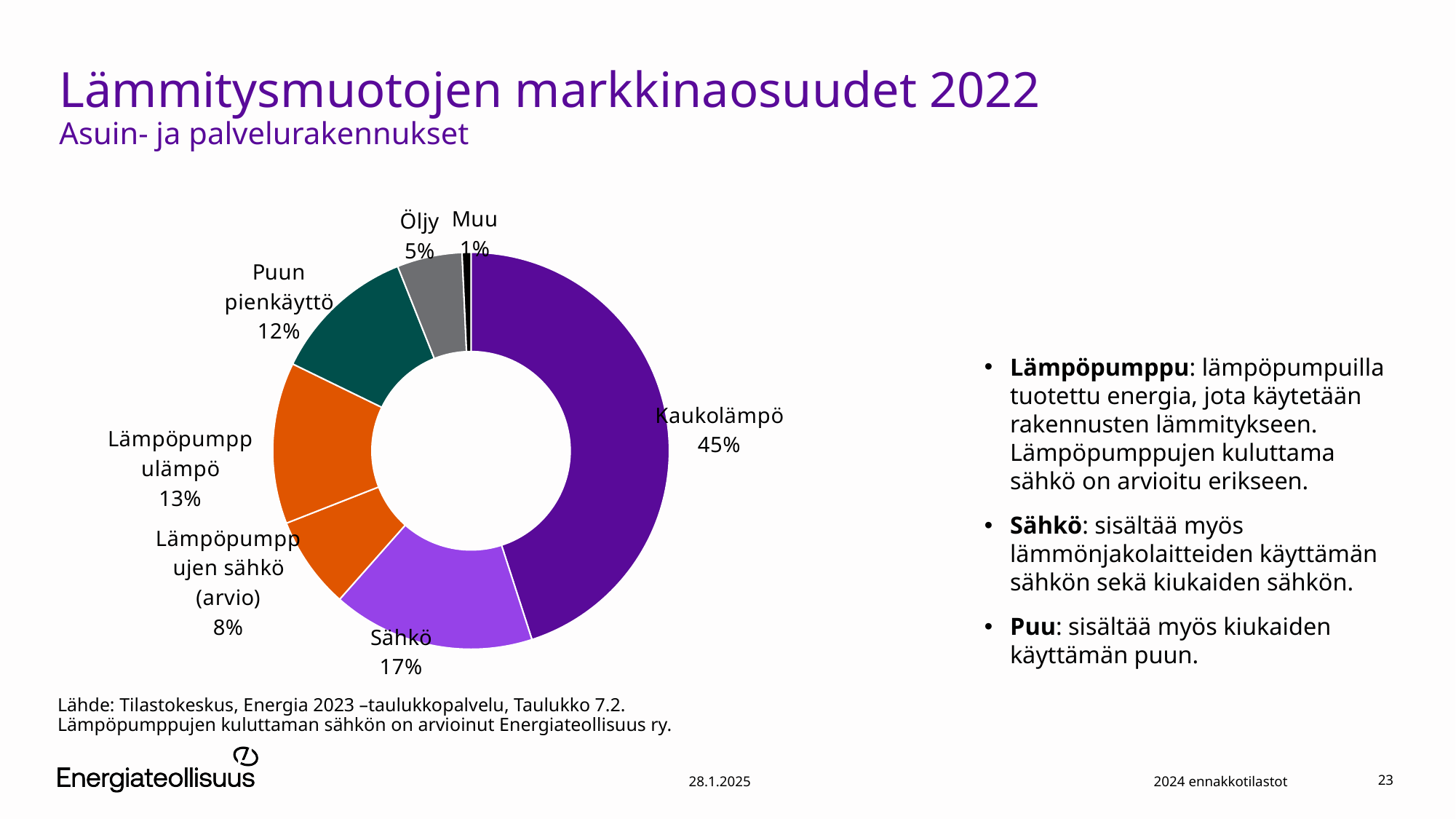
What kind of chart is shown on the slide? Pie chart (donut) Which category has the smallest share in the chart? Muu What share does Öljy have in the chart? 5% What share does Lämpöpumppujen sähkö (arvio) have in the chart? 8% Which has a larger share, Lämpöpumppulämpö or Puun pienkäyttö? Lämpöpumppulämpö What share does Puun pienkäyttö have in the chart? 12% What share does Sähkö have in the chart? 17% What share does Kaukolämpö have in the chart? 45% What is the difference in percentage points between Kaukolämpö and Sähkö? 28 How many categories are shown in the chart? 7 Which category has the largest share in the chart? Kaukolämpö What is the title of the slide? Lämmitysmuotojen markkinaosuudet 2022